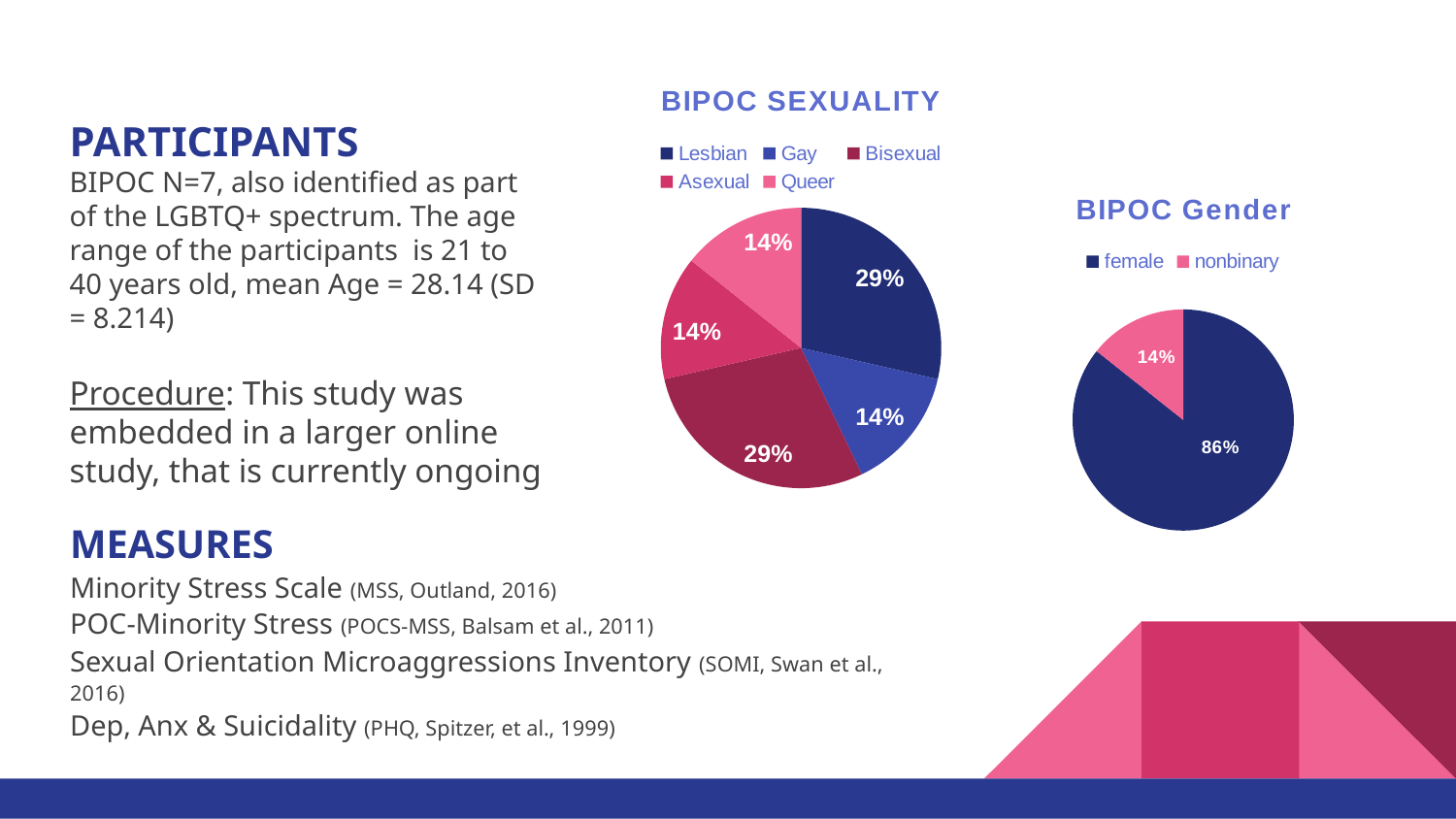
In the BIPOC Gender chart, which category is the smallest? nonbinary In the BIPOC SEXUALITY chart, which is larger, the Lesbian slice or the Gay slice? Lesbian In the BIPOC SEXUALITY chart, what share of the pie is Gay? 14% In the BIPOC SEXUALITY chart, what share of the pie is Lesbian? 29% In the BIPOC SEXUALITY chart, what share of the pie is Queer? 14% How many entries does the legend of the BIPOC Gender chart list? 2 In the BIPOC Gender chart, what is the difference between the female share and the nonbinary share? 72% In the BIPOC SEXUALITY chart, what is the difference between the Bisexual share and the Asexual share? 15% How many categories does the BIPOC SEXUALITY chart show? 5 What kind of chart is the BIPOC SEXUALITY chart? Pie chart